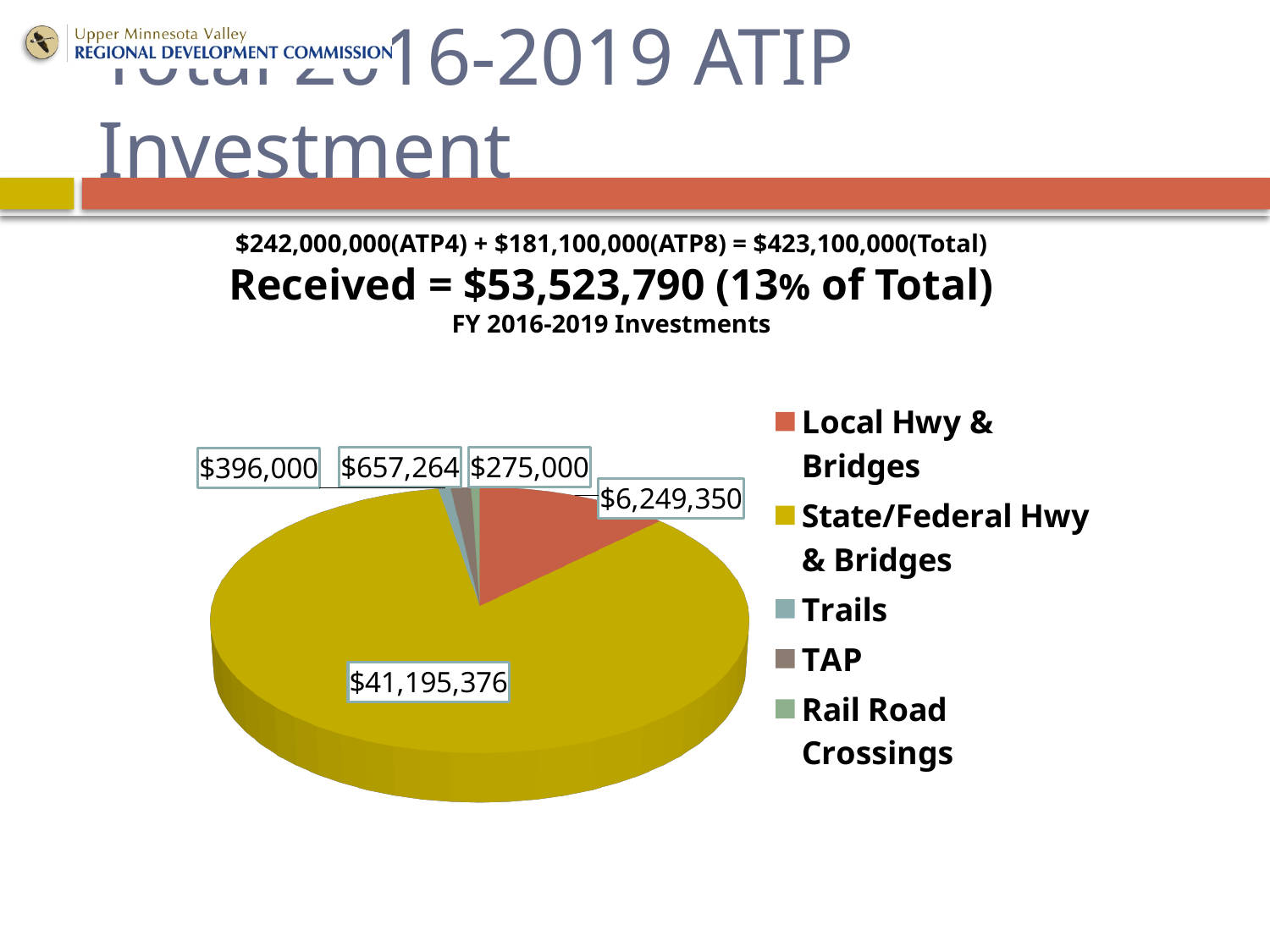
What is the smallest value labelled on the pie chart? $275,000 How many categories does the pie chart's legend list? 5 What colour represents State/Federal Hwy & Bridges in the pie chart? Yellow Which is larger, the Local Hwy & Bridges slice or the State/Federal Hwy & Bridges slice? State/Federal Hwy & Bridges What is the title of the pie chart? FY 2016-2019 Investments What is the value of the State/Federal Hwy & Bridges slice? $41,195,376 How many data labels are shown on the pie chart? 5 Which category has the largest slice of the pie? State/Federal Hwy & Bridges What is the difference between the State/Federal Hwy & Bridges value and the Local Hwy & Bridges value? $34,946,026 What is the value of the Local Hwy & Bridges slice? $6,249,350 What kind of chart is shown on the slide? Pie chart What is the total of all the values labelled on the pie chart? $48,772,990